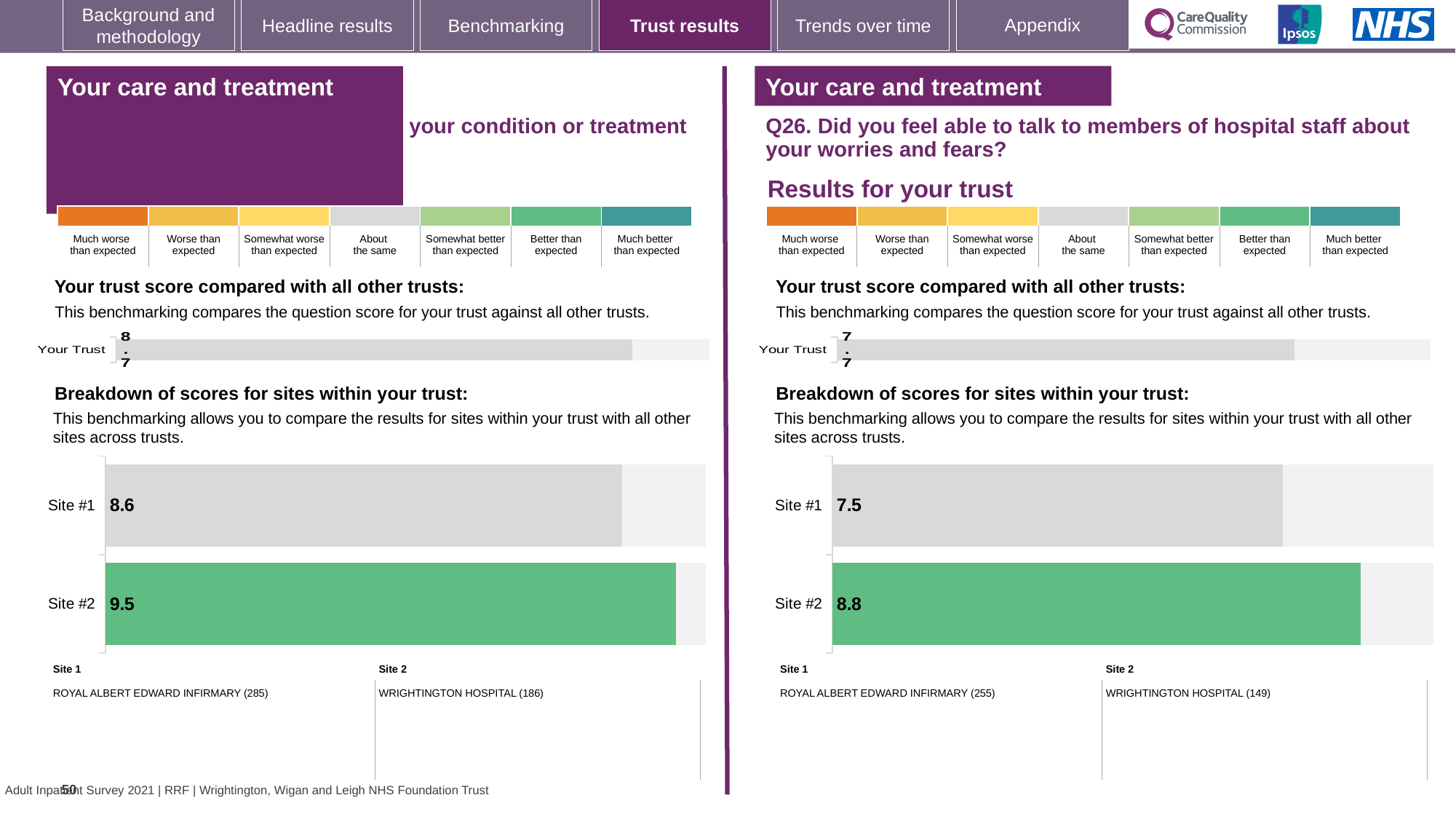
In the right-hand chart for Q26 (worries and fears), what is the score for Site #1? 7.5 In the right-hand chart for Q26 (worries and fears), what is the score for Site #2? 8.8 In the left-hand chart (your condition or treatment), what is the score for Site #2? 9.5 What type of chart is used for the breakdown of scores for sites in the right-hand Q26 section? Bar chart In the right-hand chart for Q26, what is the difference between the Site #2 and Site #1 scores? 1.3 In the right-hand chart for Q26, which site has the higher score? Site #2 In the left-hand chart (your condition or treatment), what is the difference between the Site #2 and Site #1 scores? 0.9 In the left-hand chart (your condition or treatment), what is the score for Site #1? 8.6 How many sites are shown in the site breakdown chart on the right-hand side for Q26? 2 In the left-hand chart (your condition or treatment), which site has the lower score? Site #1 In the right-hand chart for Q26, what is the 'Your Trust' score? 7.7 In the left-hand chart (your condition or treatment), what is the 'Your Trust' score? 8.7